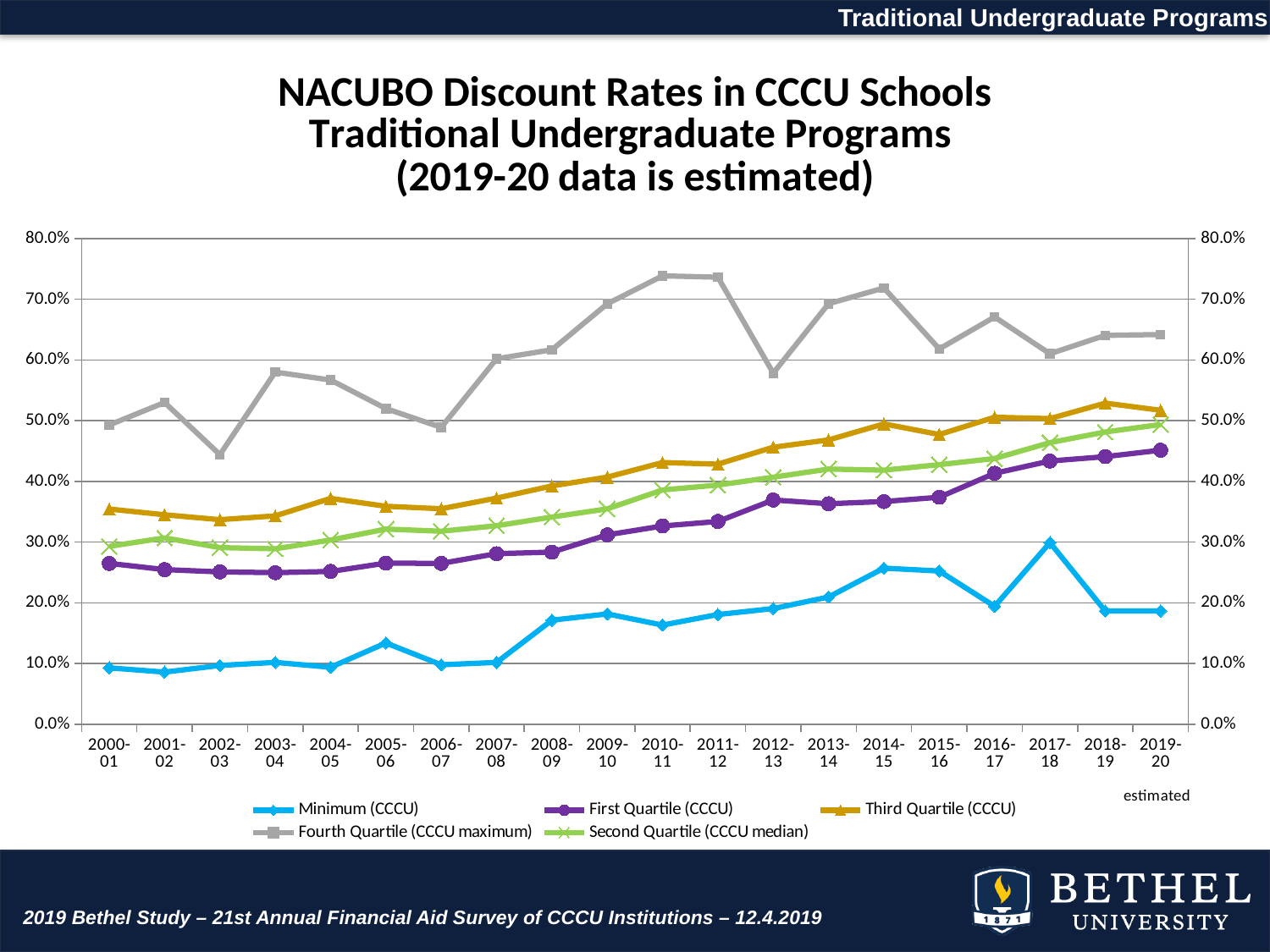
In which year is the Third Quartile (CCCU) series highest? 2018-19 Which series is drawn in gray with square markers? Fourth Quartile (CCCU maximum) How many academic years are plotted along the x axis? 20 Which is larger for the Fourth Quartile (CCCU maximum) series: the value for 2010-11 or the value for 2012-13? 2010-11 How many series does the legend list? 5 Is the Minimum (CCCU) value for 2000-01 greater or less than 10.0%? less Is the Fourth Quartile (CCCU maximum) value for 2010-11 greater or less than 70.0%? greater Is the First Quartile (CCCU) value for 2019-20 greater or less than 40.0%? greater Does the First Quartile (CCCU) series generally rise or fall from 2000-01 to 2019-20? rise In which year does the Minimum (CCCU) series reach its highest value? 2017-18 What kind of chart is shown on the slide? line chart In which year is the Fourth Quartile (CCCU maximum) series at its lowest? 2002-03